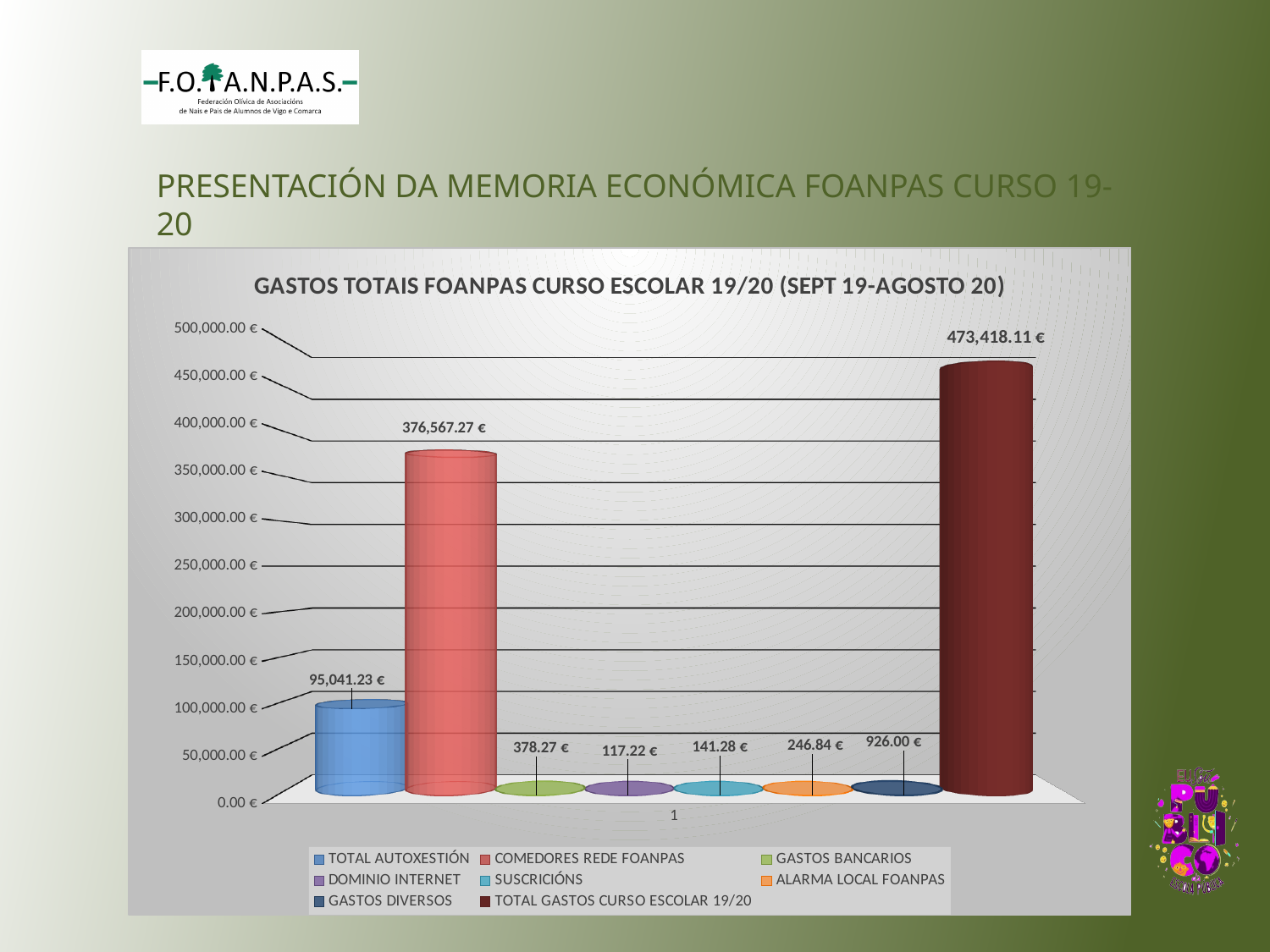
What is the difference between GASTOS DIVERSOS and GASTOS BANCARIOS? 547.73 € Which series has the highest value? TOTAL GASTOS CURSO ESCOLAR 19/20 Which series has the lowest value? DOMINIO INTERNET What is the value for TOTAL AUTOXESTIÓN? 95,041.23 € What is the title of the chart? GASTOS TOTAIS FOANPAS CURSO ESCOLAR 19/20 (SEPT 19-AGOSTO 20) What kind of chart is shown? Bar chart Which is larger, ALARMA LOCAL FOANPAS or SUSCRICIÓNS? ALARMA LOCAL FOANPAS What is the value for GASTOS DIVERSOS? 926.00 € What is the value for COMEDORES REDE FOANPAS? 376,567.27 € What is the difference between TOTAL GASTOS CURSO ESCOLAR 19/20 and COMEDORES REDE FOANPAS? 96,850.84 € How many series does the legend list? 8 What is the value for DOMINIO INTERNET? 117.22 €